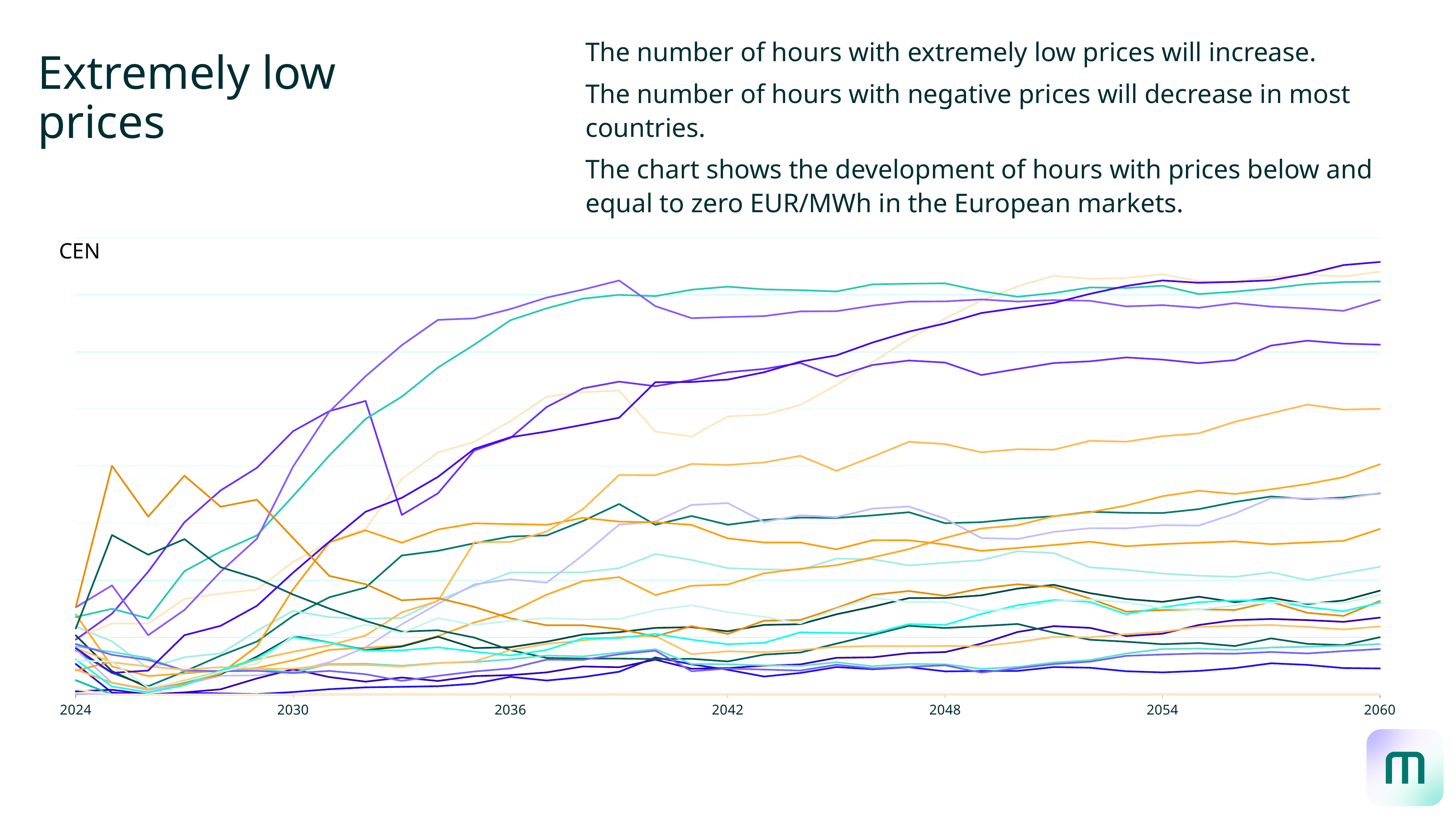
What is the interval in years between consecutive x-axis labels on the chart? 6 Overall, do the lines in the chart rise or fall from 2024 to 2060? rise How many year labels are printed along the x axis of the chart? 7 What label is printed in the top-left corner of the chart area? CEN What kind of chart is shown on the slide? line chart Does the chart display a legend identifying the lines? No What is the last year shown on the x axis of the chart? 2060 What is the first year shown on the x axis of the chart? 2024